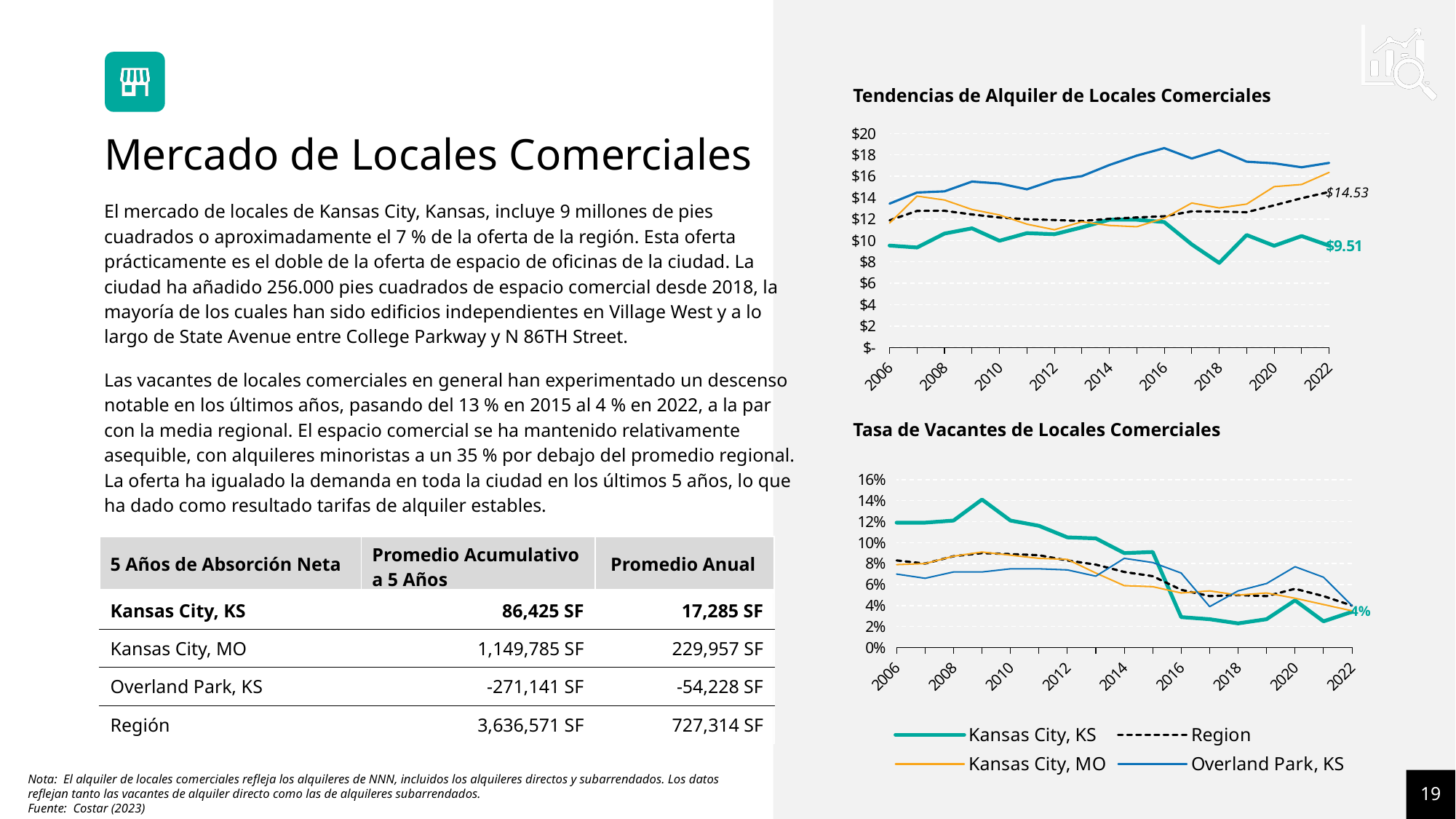
In the chart titled 'Tendencias de Alquiler de Locales Comerciales', what is the labelled value for Region in 2022? $14.53 In the chart titled 'Tendencias de Alquiler de Locales Comerciales', what is the difference between the 2022 labelled values for Region and Kansas City, KS? $5.02 In the chart titled 'Tendencias de Alquiler de Locales Comerciales', is the value for Kansas City, KS in 2018 greater or less than $10? less In the chart titled 'Tasa de Vacantes de Locales Comerciales', is the value for Kansas City, KS in 2009 greater or less than 12%? greater In the chart titled 'Tasa de Vacantes de Locales Comerciales', which series has the highest value in 2006? Kansas City, KS In the chart titled 'Tasa de Vacantes de Locales Comerciales', what is the labelled value for Kansas City, KS in 2022? 4% How many series does the legend below the 'Tasa de Vacantes de Locales Comerciales' chart list? 4 What kind of chart is 'Tasa de Vacantes de Locales Comerciales'? Line chart In the chart titled 'Tendencias de Alquiler de Locales Comerciales', what is the labelled value for Kansas City, KS in 2022? $9.51 In the chart titled 'Tendencias de Alquiler de Locales Comerciales', is the value for Overland Park, KS in 2016 greater or less than $16? greater In the chart titled 'Tendencias de Alquiler de Locales Comerciales', which is higher in 2022: Overland Park, KS or Kansas City, KS? Overland Park, KS In the chart titled 'Tasa de Vacantes de Locales Comerciales', does the Kansas City, KS line rise or fall from 2009 to 2022? Fall